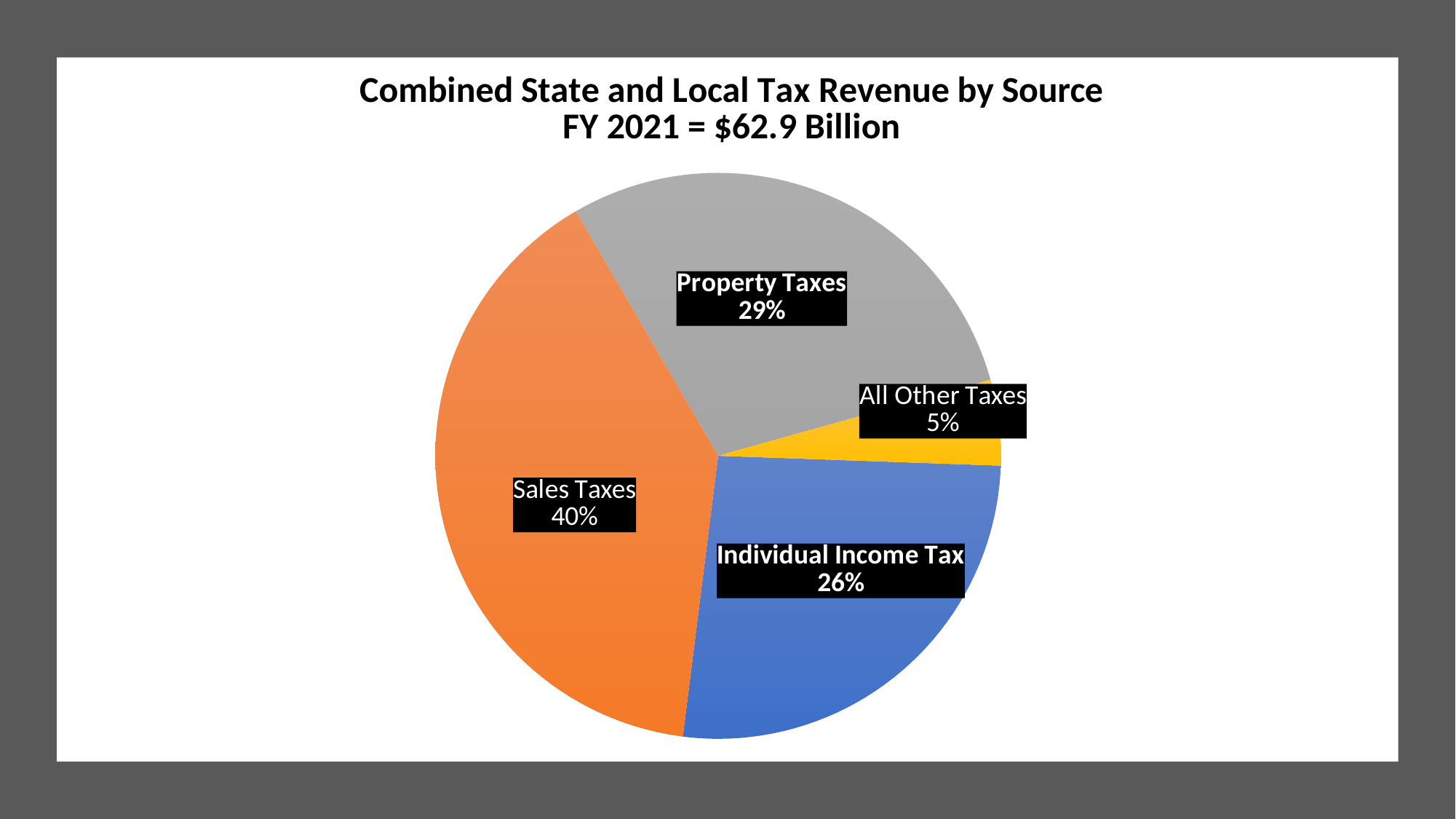
What share of combined state and local tax revenue comes from Sales Taxes? 40% What is the value shown for Individual Income Tax? 26% How many tax sources are shown in the pie chart? 4 What total revenue amount for FY 2021 is stated in the chart title? $62.9 Billion What kind of chart is shown on the slide? Pie chart How many percentage points larger is the Sales Taxes share than the Individual Income Tax share? 14 What is the difference in percentage points between Property Taxes and All Other Taxes? 24 What percentage is labelled for All Other Taxes? 5% Which is larger, the Property Taxes share or the Individual Income Tax share? Property Taxes Which tax source has the largest share of revenue? Sales Taxes Which tax source has the smallest share of revenue? All Other Taxes What percentage of the pie is Property Taxes? 29%